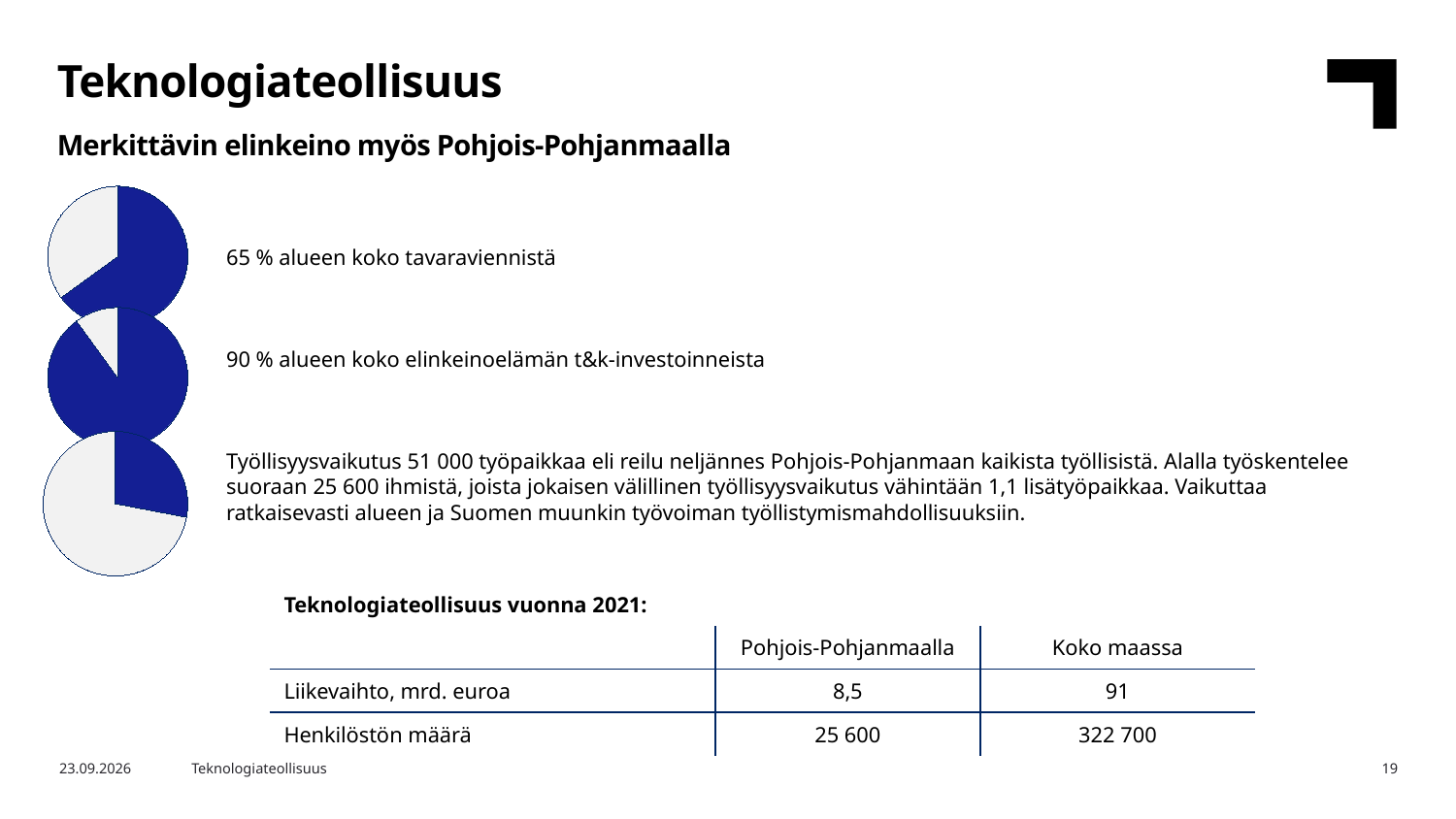
What colour is used for the highlighted slice in each pie chart? Dark blue According to the middle pie chart, what share of the region's business R&D investments does the technology industry account for? 90 % What kind of charts are shown on the left side of the slide? Pie charts Which of the three pie charts has the smallest highlighted (blue) slice? The bottom pie chart (employment share) Is the highlighted share in the top pie chart (goods exports) larger or smaller than the highlighted share in the middle pie chart (R&D investments)? Smaller What is the difference between the share shown in the middle pie chart (90 %) and the share shown in the top pie chart (65 %)? 25 percentage points Is the highlighted slice in the bottom pie chart greater or less than 50 %? less What is the main title of the slide containing the pie charts? Teknologiateollisuus How many pie charts are shown on the slide? 3 According to the top pie chart, what share of the region's total goods exports does the technology industry account for? 65 % Which of the three pie charts has the largest highlighted (blue) slice? The middle pie chart (90 % of R&D investments)